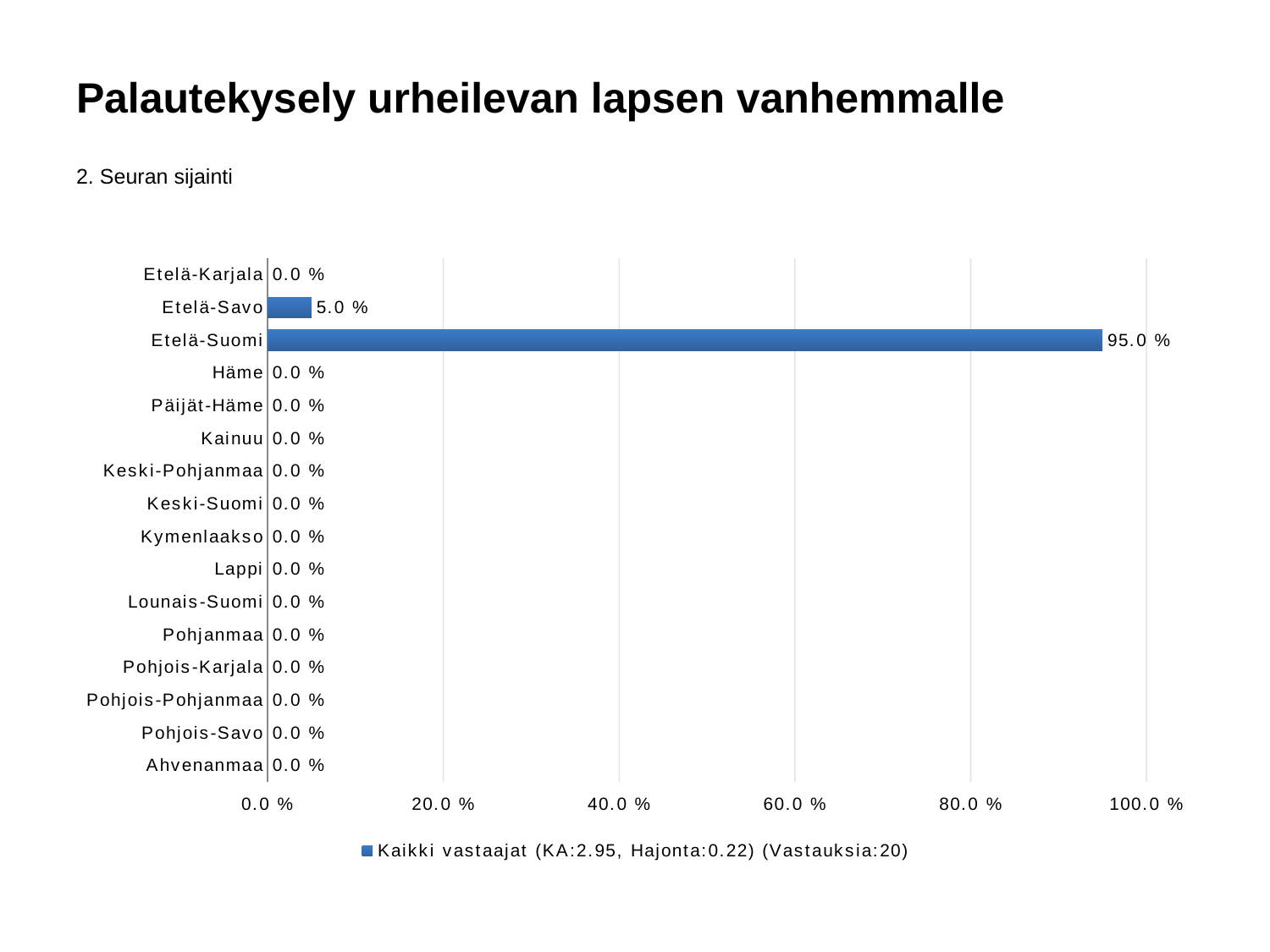
What kind of chart is shown on the slide? bar chart What is the difference between the values for Etelä-Suomi and Etelä-Savo? 90.0 % How many categories have a value of 0.0 %? 14 What is the value for Etelä-Suomi? 95.0 % Is the value for Etelä-Suomi greater or less than 80.0 %? greater What is the value for Etelä-Savo? 5.0 % Which is larger, the value for Etelä-Savo or the value for Häme? Etelä-Savo What is the value for Lappi? 0.0 % Which category has the highest value? Etelä-Suomi How many categories are shown on the chart? 16 What is the legend entry for the series? Kaikki vastaajat (KA:2.95, Hajonta:0.22) (Vastauksia:20) How many series does the legend list? 1